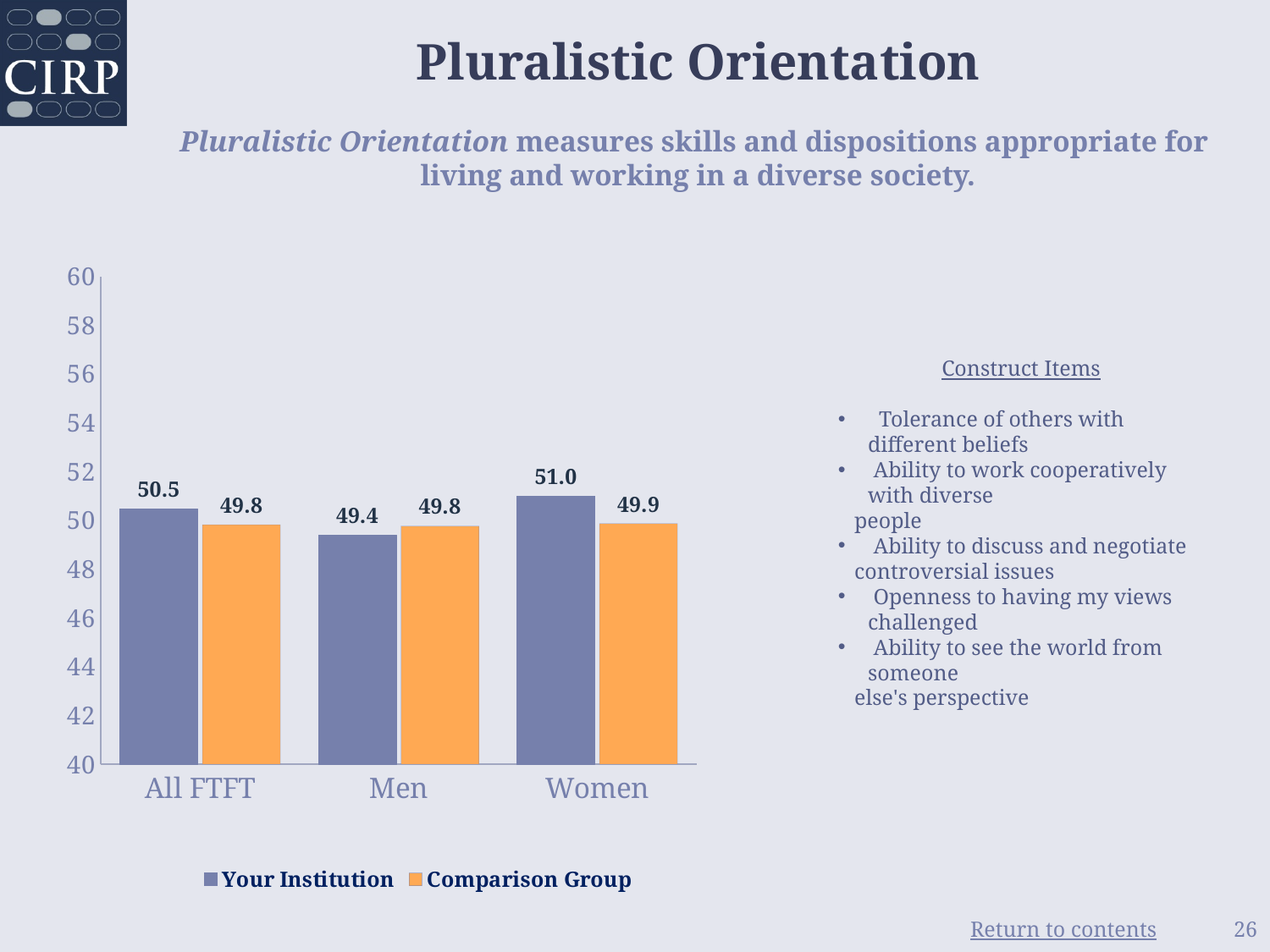
What is the difference between Your Institution and the Comparison Group in the Women category? 1.1 How many series does the legend list? 2 What colour are the Comparison Group bars? orange Which category has the highest value for Your Institution? Women What is the value for the Comparison Group in the Women category? 49.9 Which category has the lowest value for Your Institution? Men What is the value for Your Institution in the All FTFT category? 50.5 How many categories are shown on the x axis? 3 Is the value for Your Institution in the Women category greater or less than 50? greater In the Men category, which is larger: Your Institution or the Comparison Group? Comparison Group What kind of chart is shown on the slide? bar chart What is the value for Your Institution in the Men category? 49.4